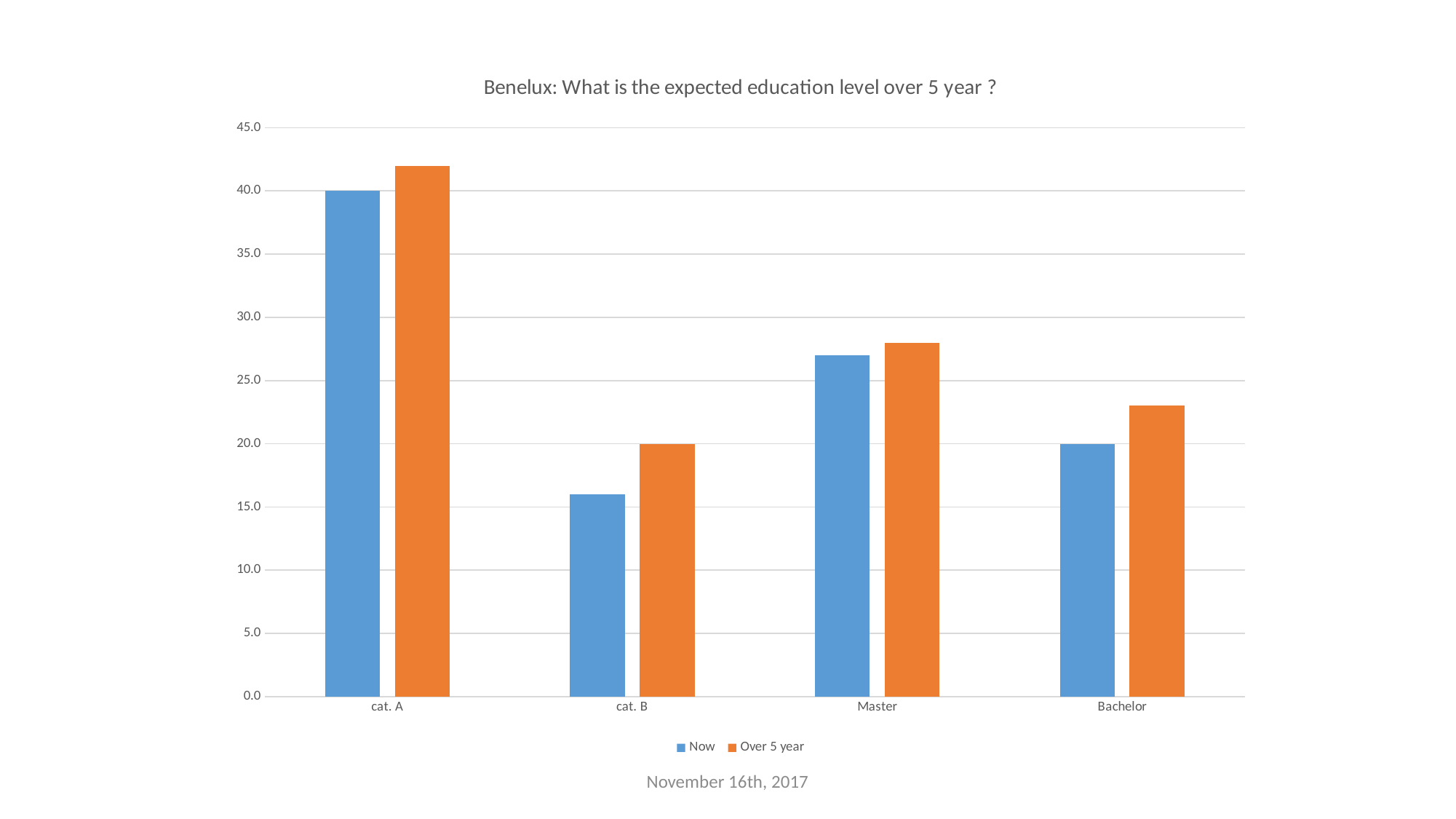
Which category has the lowest value in the Now series? cat. B What type of chart is shown on the slide? bar chart Is the value for cat. A in the Over 5 year series greater or less than 40.0? greater Which category has the highest value in the Over 5 year series? cat. A What is the title of the chart? Benelux: What is the expected education level over 5 year ? How many series does the legend list? 2 How many categories are shown on the x axis? 4 What is the value for cat. A in the Now series? 40.0 What is the value for Bachelor in the Now series? 20.0 Is the value for cat. B in the Now series greater or less than 20.0? less For Bachelor, which series has the larger value, Now or Over 5 year? Over 5 year What is the value for cat. B in the Over 5 year series? 20.0